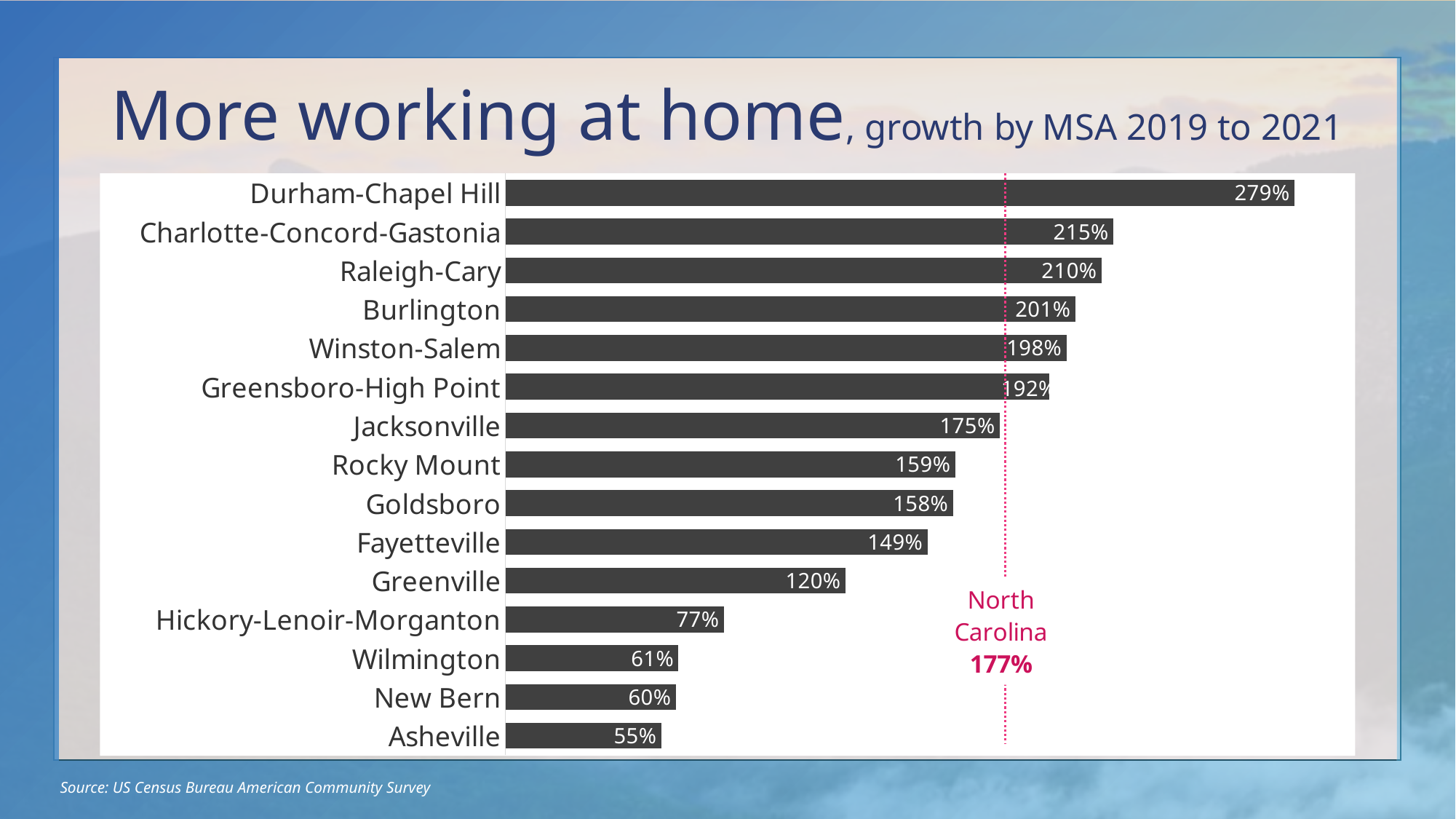
What kind of chart is shown on the slide? Bar chart What is the growth value shown for Asheville? 55% What growth value is shown for North Carolina by the dotted reference line? 177% What is the growth value shown for Greensboro-High Point? 192% How many MSAs are plotted in the chart? 15 Which has a larger growth value, Jacksonville or Greenville? Jacksonville What is the difference between the growth values for Charlotte-Concord-Gastonia and Raleigh-Cary? 5% What is the difference between the growth values for Durham-Chapel Hill and Asheville? 224% Which MSA has the highest growth in working at home? Durham-Chapel Hill What is the source cited for the chart data? US Census Bureau American Community Survey Which MSA has the lowest growth in working at home? Asheville What is the growth value shown for Durham-Chapel Hill? 279%